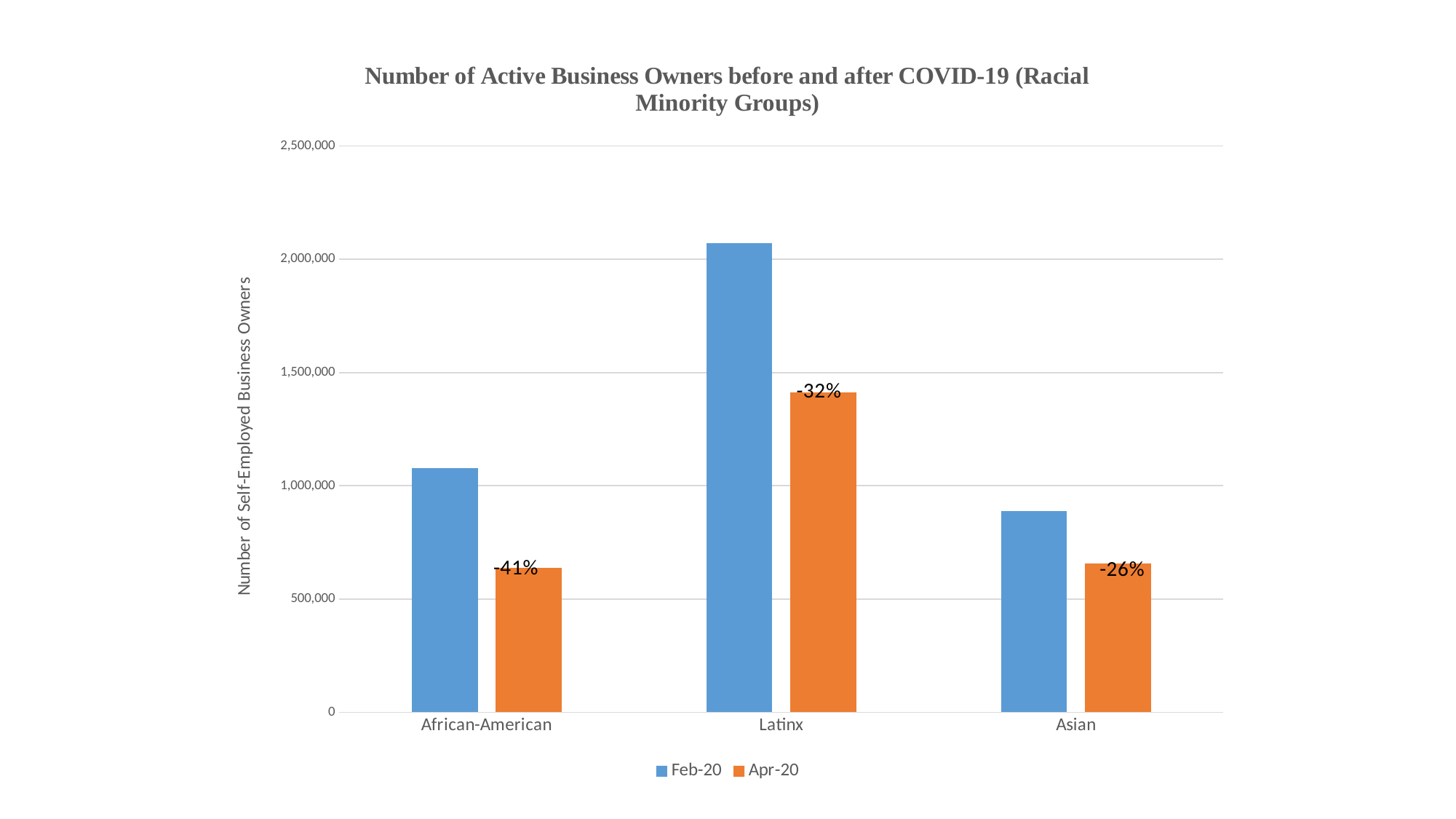
Is the Feb-20 value for Latinx greater or less than 2,000,000? greater Is the Apr-20 value for Latinx greater or less than 1,500,000? less What percentage change is labelled on the Apr-20 bar for Latinx? -32% Which category has the highest Feb-20 value? Latinx Which category has the lowest Feb-20 value? Asian What type of chart is shown on the slide? bar chart What is the label of the y axis? Number of Self-Employed Business Owners What percentage change is labelled on the Apr-20 bar for Asian? -26% Is the Feb-20 value for Asian greater or less than 1,000,000? less What percentage change is labelled on the Apr-20 bar for African-American? -41% How many categories are shown on the x axis? 3 How many series does the legend list? 2